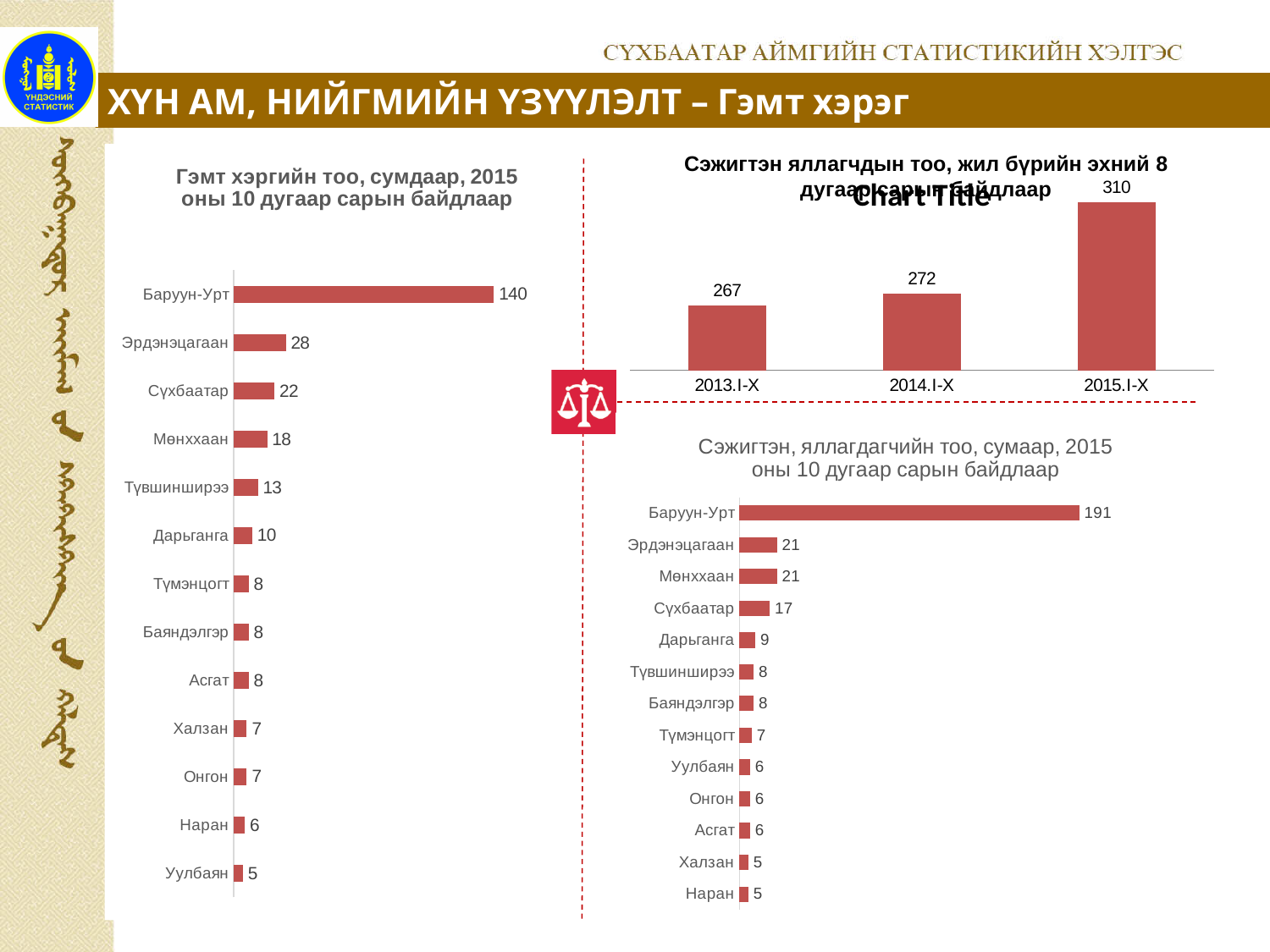
In the left chart (Гэмт хэргийн тоо, сумдаар), which category has the lowest value? Уулбаян What type of chart is the bottom right chart (Сэжигтэн, яллагдагчийн тоо, сумаар)? bar chart In the left chart (Гэмт хэргийн тоо, сумдаар), what is the value for Түвшинширээ? 13 In the left chart (Гэмт хэргийн тоо, сумдаар), what is the difference between Эрдэнэцагаан and Сүхбаатар? 6 In the top right chart, do the values rise or fall from 2013.I-X to 2015.I-X? rise In the bottom right chart (Сэжигтэн, яллагдагчийн тоо, сумаар), which is larger, Сүхбаатар or Дарьганга? Сүхбаатар In the left chart (Гэмт хэргийн тоо, сумдаар), how many categories are shown? 13 In the top right chart, what is the value for 2015.I-X? 310 In the bottom right chart (Сэжигтэн, яллагдагчийн тоо, сумаар), what is the value for Баруун-Урт? 191 In the top right chart, what is the difference between 2015.I-X and 2013.I-X? 43 In the top right chart, how many bars are shown? 3 In the left chart (Гэмт хэргийн тоо, сумдаар), what is the value for Баруун-Урт? 140